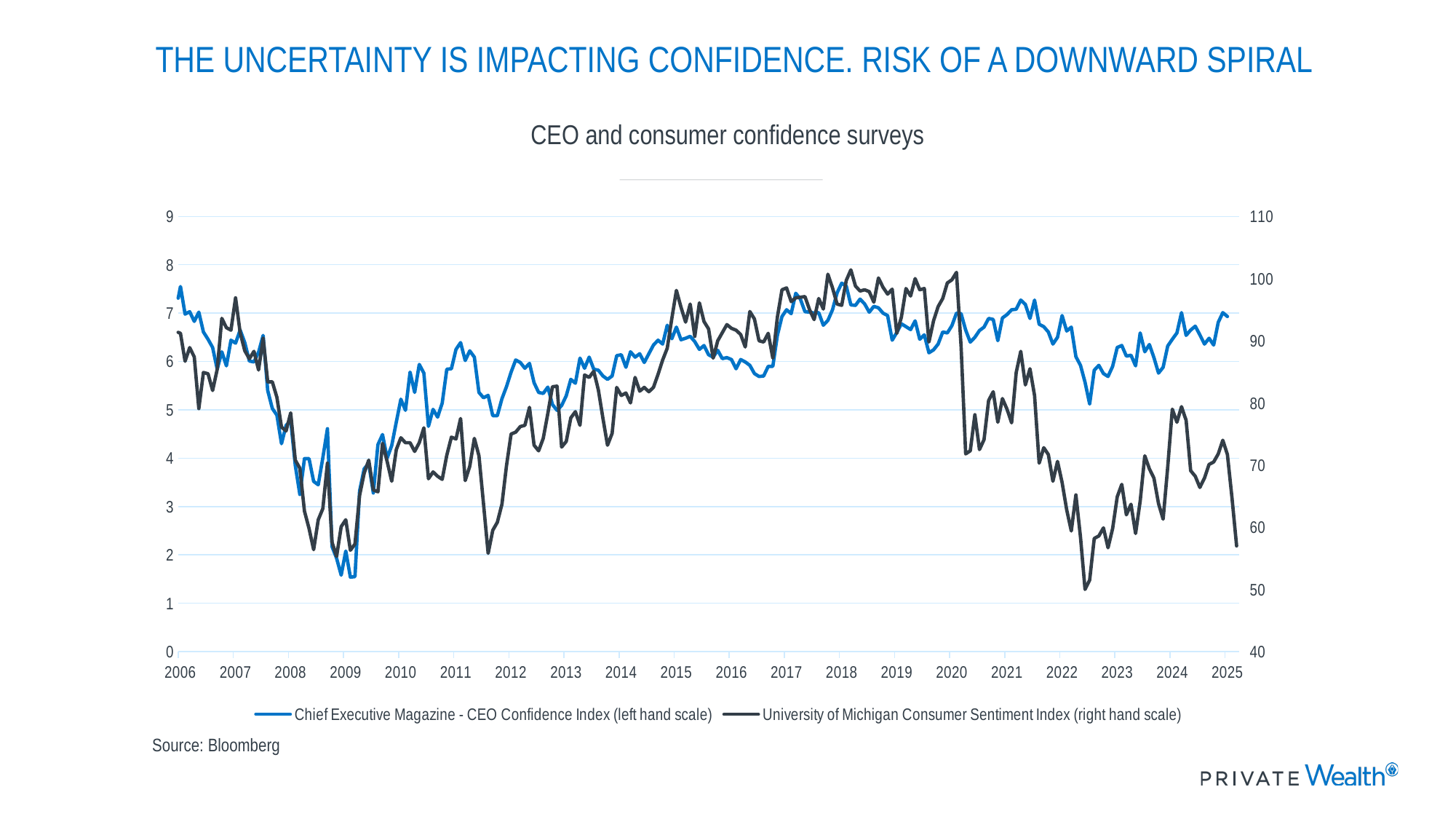
Is the value of the Chief Executive Magazine CEO Confidence Index at the start of 2006 greater or less than 7? greater What kind of chart is shown on the slide? Line chart What is the title of the chart? CEO and consumer confidence surveys Which series is plotted on the right hand scale according to the legend? University of Michigan Consumer Sentiment Index How many series does the legend list? 2 Is the value of the University of Michigan Consumer Sentiment Index at its low point in 2022 greater or less than 60? less Is the value of the University of Michigan Consumer Sentiment Index at the end of the series in 2025 greater or less than 60? less Does the University of Michigan Consumer Sentiment Index rise or fall between 2024 and the end of the series in 2025? fall What is the first year shown on the x axis? 2006 Does the Chief Executive Magazine CEO Confidence Index rise or fall between early 2009 and 2010? rise